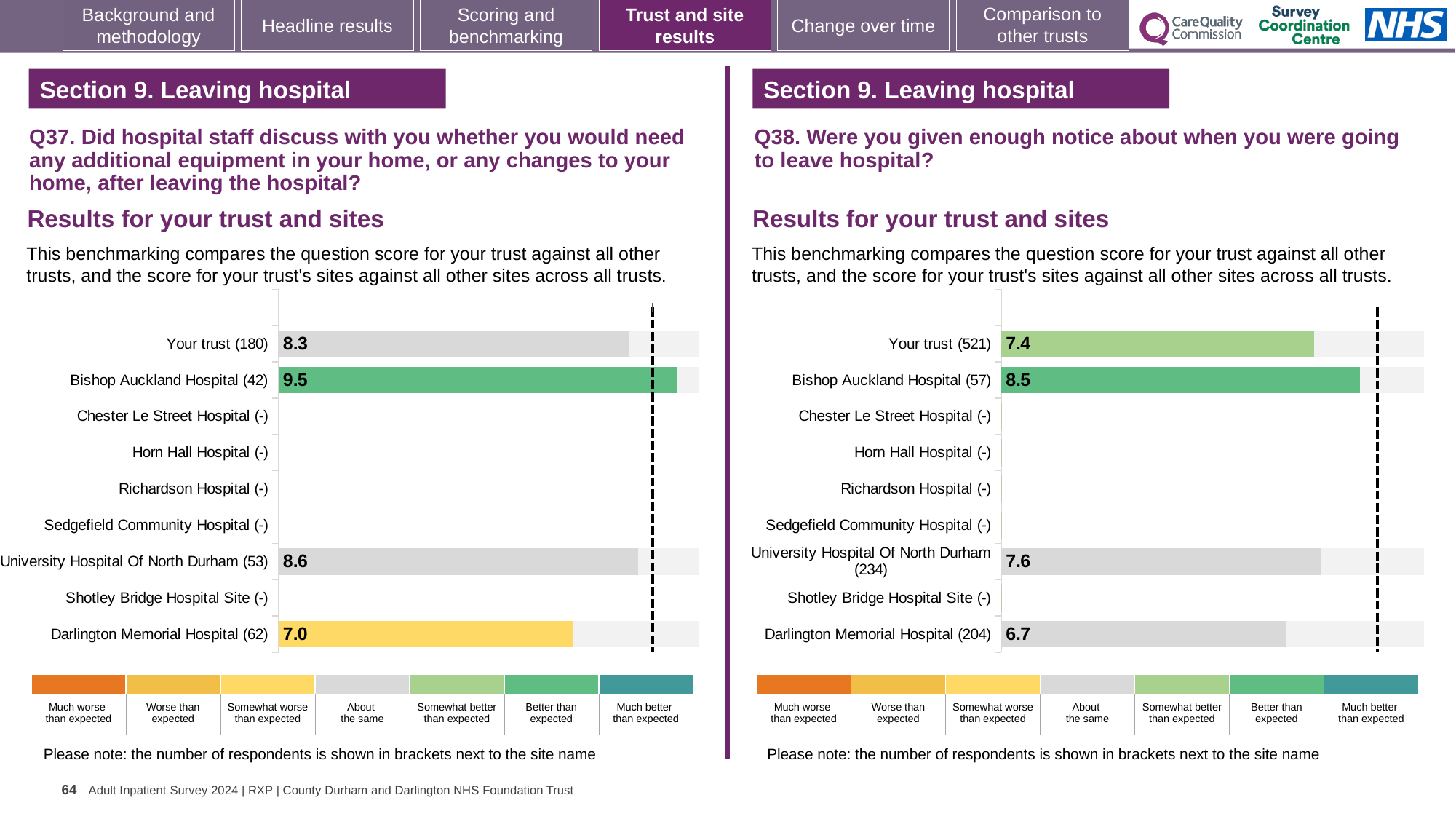
In the Q38 chart on the right, how many site rows (excluding Your trust) are listed? 8 In the Q37 chart on the left, what is the score for Your trust? 8.3 In the Q38 chart on the right, what is the difference between the scores for Bishop Auckland Hospital and Your trust? 1.1 In the Q38 chart on the right, what is the score for Darlington Memorial Hospital? 6.7 In the Q37 chart on the left, how many respondents are shown for University Hospital Of North Durham? 53 In the Q38 chart on the right, what is the score for Your trust? 7.4 In the Q37 chart on the left, what is the difference between the scores for Bishop Auckland Hospital and Darlington Memorial Hospital? 2.5 In the Q38 chart on the right, which is larger: the score for University Hospital Of North Durham or the score for Your trust? University Hospital Of North Durham In the Q38 chart on the right, which site has the highest score? Bishop Auckland Hospital What kind of chart is used in the Q37 chart on the left? Bar chart In the Q37 chart on the left, which site has the lowest score? Darlington Memorial Hospital In the Q37 chart on the left, what is the score for Bishop Auckland Hospital? 9.5